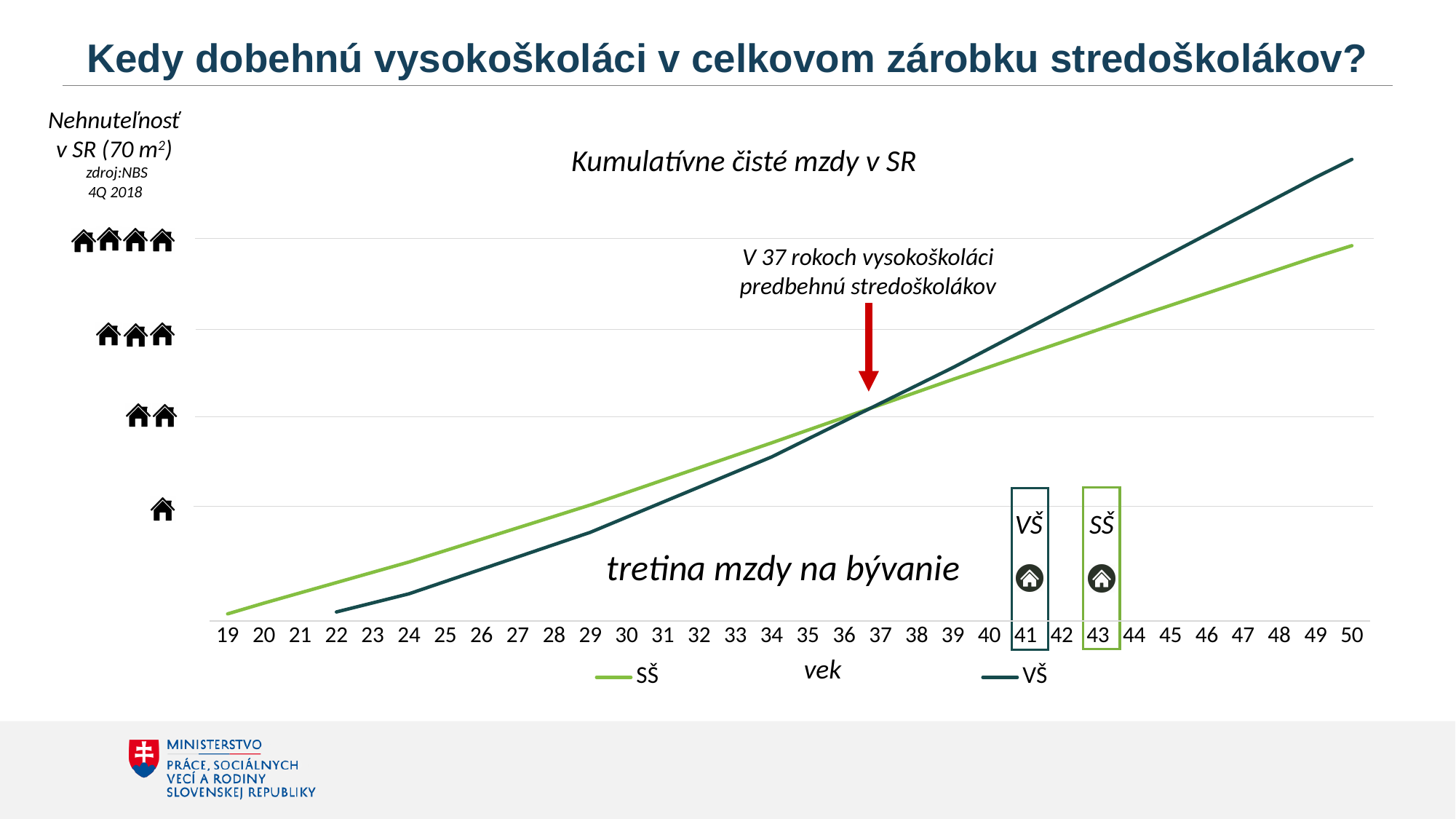
At what age does the VŠ line start on the x axis? 22 At age 30, which series has the higher value, SŠ or VŠ? SŠ How many series does the chart legend list? 2 At age 25, which series has the lower value, SŠ or VŠ? VŠ What kind of chart is shown on the slide? line chart What are the two series named in the chart legend? SŠ and VŠ How many age values are labelled on the x axis of the chart? 32 At age 50, which series has the higher value, SŠ or VŠ? VŠ What is the title of the chart? Kumulatívne čisté mzdy v SR At what age does the VŠ line overtake the SŠ line according to the annotation on the chart? 37 Do the values of the VŠ series rise or fall as age increases along the x axis? rise Do the values of the SŠ series rise or fall as age increases along the x axis? rise